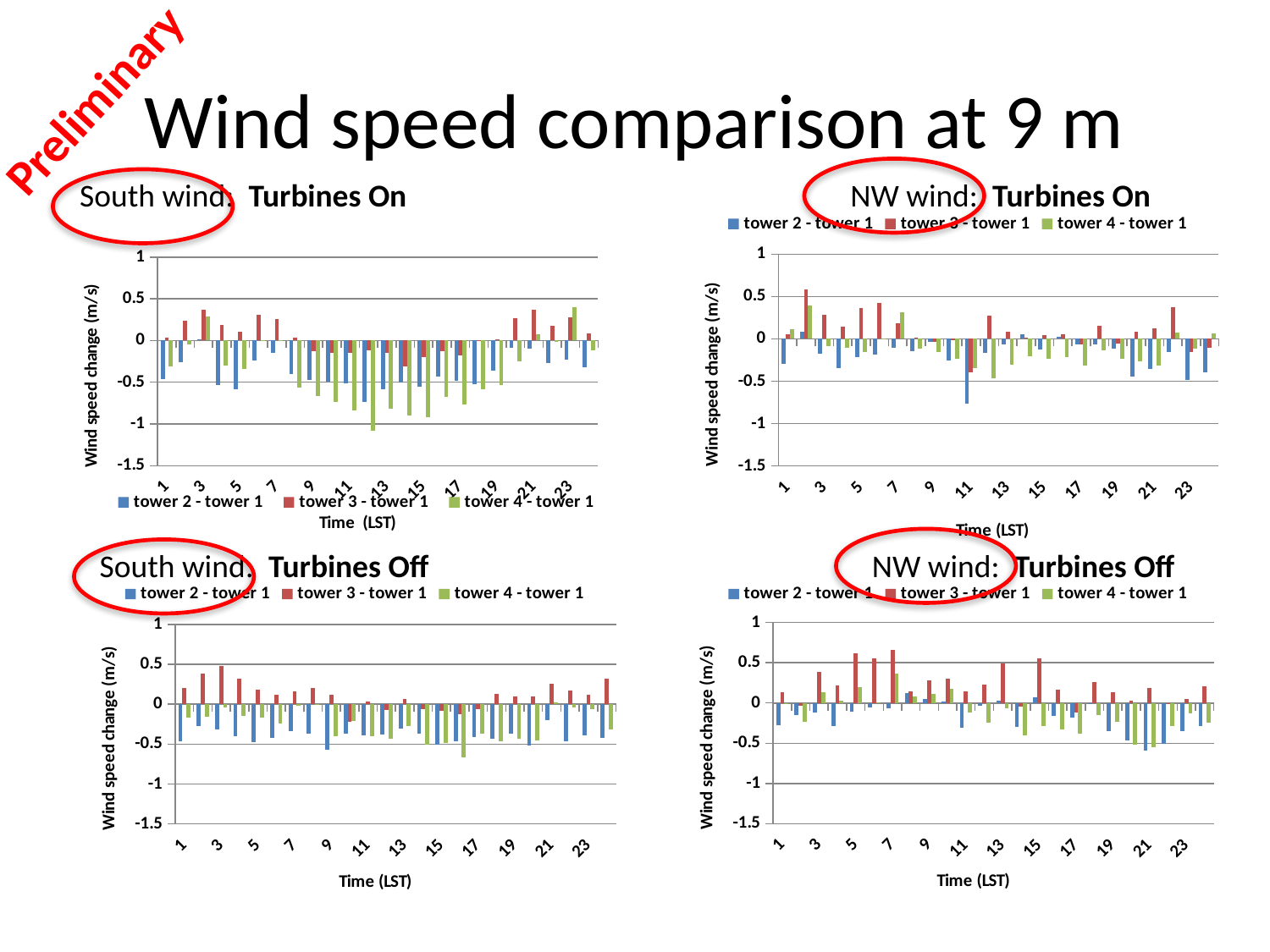
In the 'South wind: Turbines On' chart at hour 13, which is larger: tower 2 - tower 1 or tower 4 - tower 1? tower 2 - tower 1 In the 'South wind: Turbines On' chart, is the value for tower 4 - tower 1 at hour 13 greater or less than -1? greater In the 'NW wind: Turbines On' chart, is the value for tower 3 - tower 1 at hour 2 greater or less than 0.5? greater In the 'NW wind: Turbines Off' chart, is the value for tower 3 - tower 1 at hour 7 greater or less than 0.5? greater In the 'South wind: Turbines On' chart, which series has the lowest value at hour 13? tower 4 - tower 1 How many series does the legend of the 'NW wind: Turbines Off' chart list? 3 What kind of chart is the 'South wind: Turbines On' chart? bar chart In the 'South wind: Turbines Off' chart, what are the three legend entries? tower 2 - tower 1, tower 3 - tower 1, tower 4 - tower 1 What is the y-axis title of the 'NW wind: Turbines On' chart? Wind speed change (m/s)